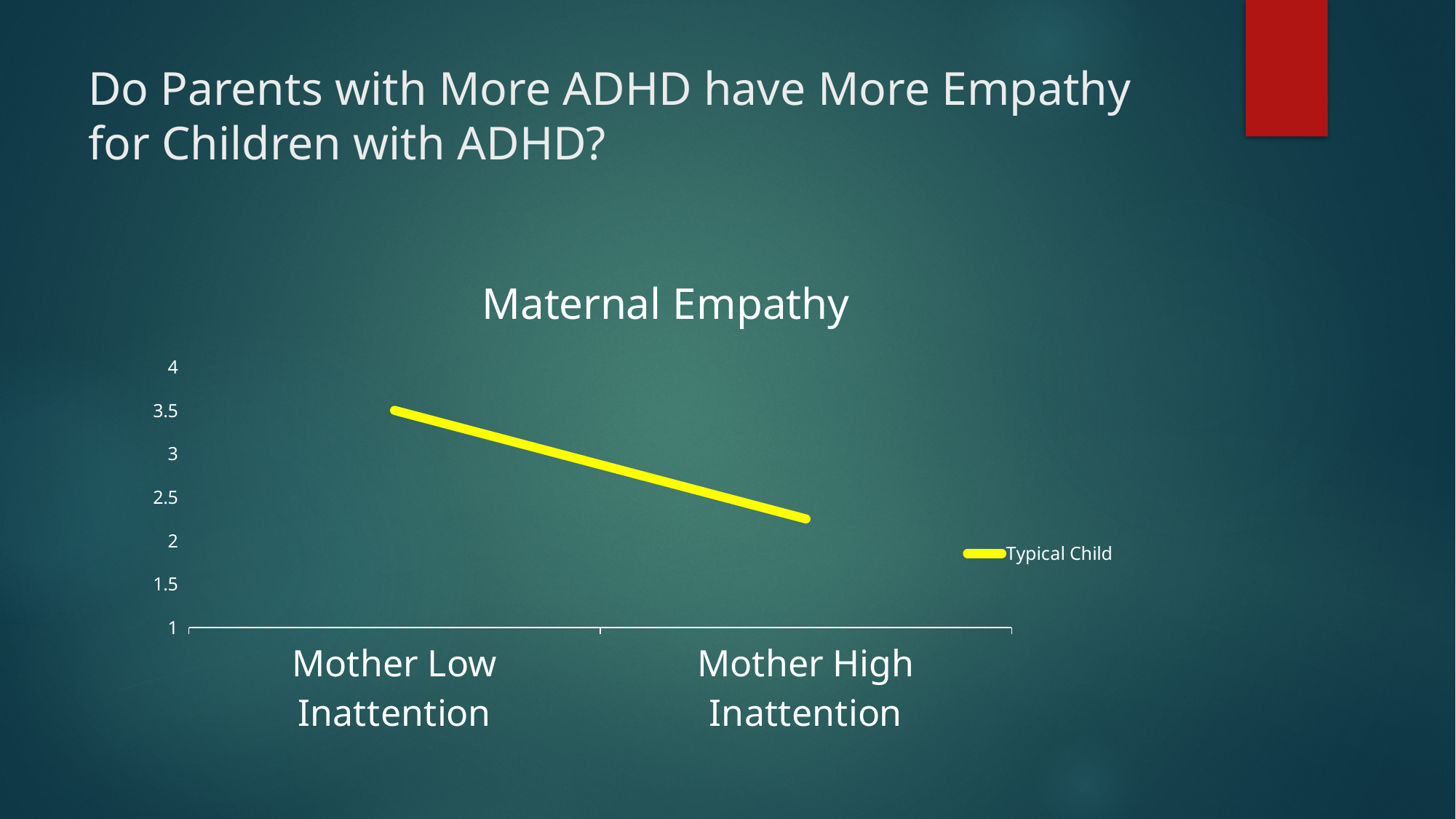
Is the value for Mother High Inattention greater or less than 2? greater Is the value for Mother Low Inattention greater or less than 3? greater Is the value for Mother High Inattention greater or less than 2.5? less What kind of chart is shown on the slide? line chart What is the name of the series shown in the legend? Typical Child Does the Typical Child line rise or fall from Mother Low Inattention to Mother High Inattention? fall Is the value for Mother Low Inattention larger or smaller than the value for Mother High Inattention? larger Which category has the lower value for Typical Child? Mother High Inattention What is the title of the chart? Maternal Empathy How many categories are shown on the x axis? 2 Which category has the higher value for Typical Child? Mother Low Inattention How many series does the legend list? 1